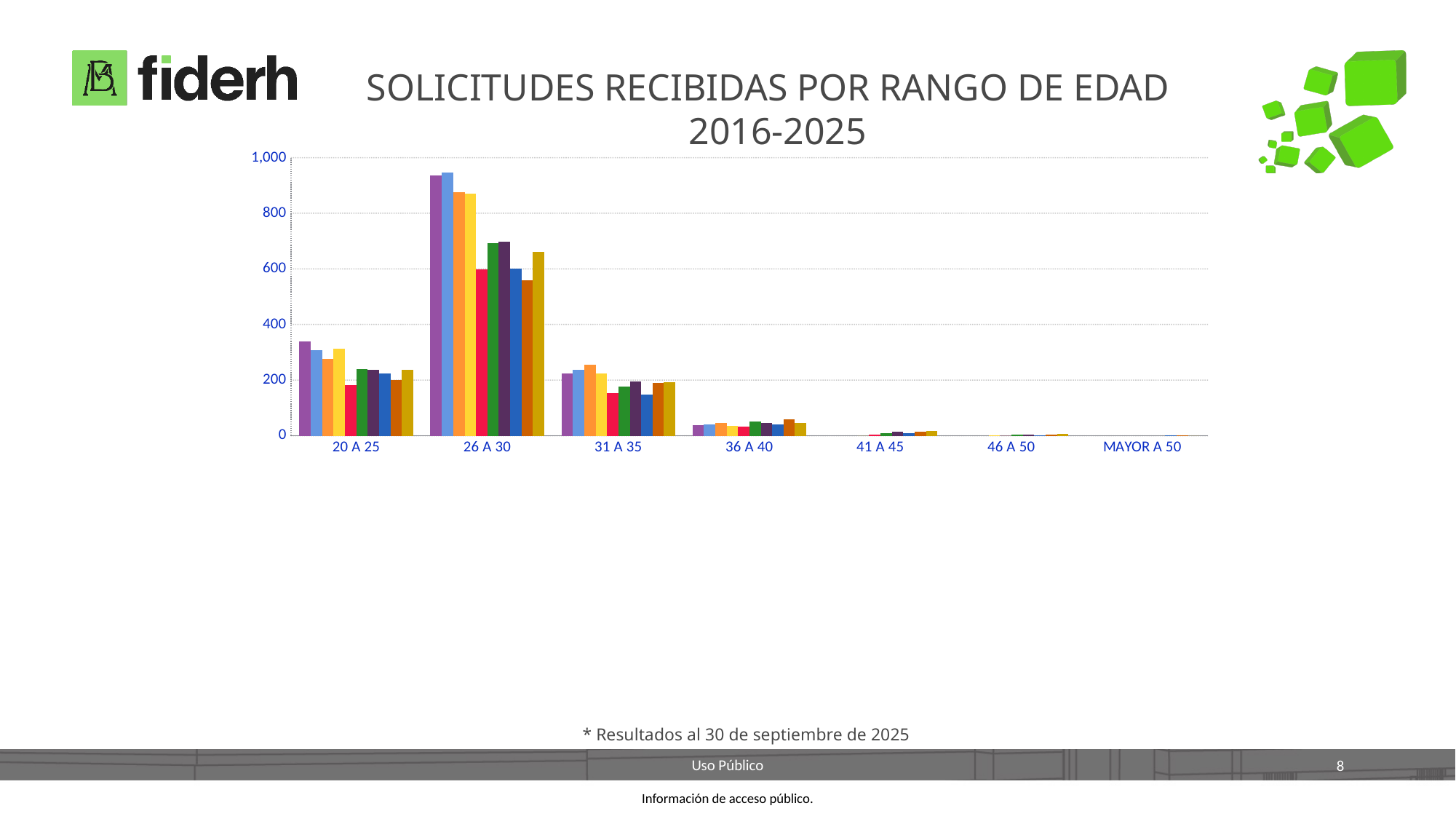
Which age range has the highest number of applications received? 26 A 30 Is the tallest bar in the 36 A 40 category greater or less than 200? less What is the title of the chart? SOLICITUDES RECIBIDAS POR RANGO DE EDAD 2016-2025 What kind of chart is shown on the slide? bar chart Is the shortest bar in the 26 A 30 category greater or less than 400? greater How many bars are plotted for each age-range category? 10 Is the tallest bar in the 20 A 25 category greater or less than 400? less Which category has larger values, 26 A 30 or 31 A 35? 26 A 30 Do the values rise or fall along the x axis from 26 A 30 to MAYOR A 50? fall How many age-range categories are shown on the x axis? 7 Which age range has the lowest number of applications received? MAYOR A 50